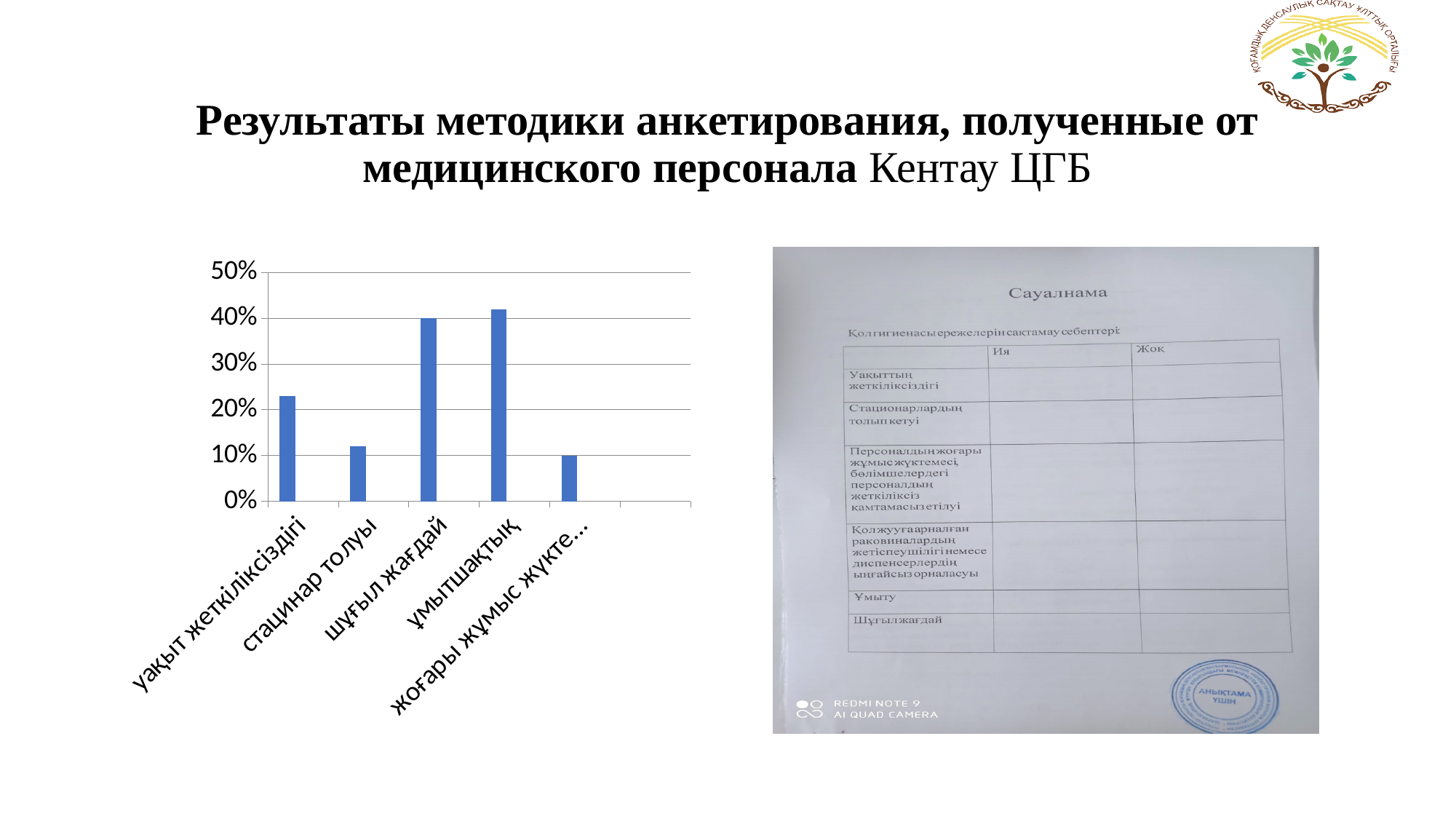
Is the value for ұмытшақтық greater or less than 50%? less Is the value for уақыт жеткіліксіздігі greater or less than 20%? greater Which is larger in the bar chart: уақыт жеткіліксіздігі or стацинар толуы? уақыт жеткіліксіздігі Is the value for ұмытшақтық greater or less than 30%? greater What colour are the bars in the chart? blue How many categories are plotted in the bar chart? 5 What is the value for шұғыл жағдай in the bar chart? 40% What is the highest value shown on the vertical axis of the bar chart? 50% What kind of chart is shown on the left of the slide? bar chart What is the value for жоғары жұмыс жүкте... in the bar chart? 10% Which is larger in the bar chart: шұғыл жағдай or жоғары жұмыс жүкте...? шұғыл жағдай